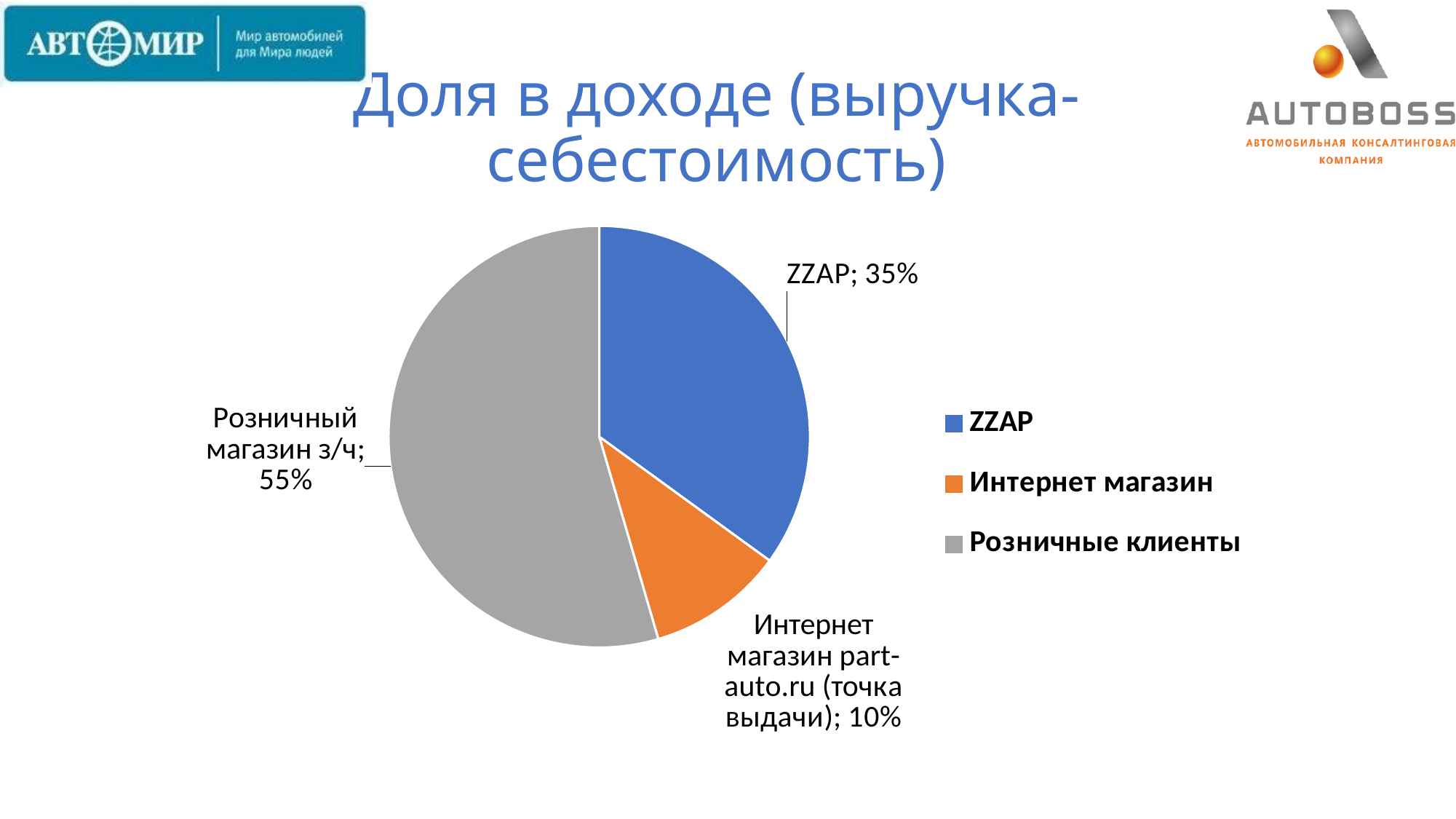
Which slice of the pie is the largest? Розничный магазин з/ч How many entries does the legend list? 3 What is the difference in percentage points between the Розничный магазин з/ч slice and the ZZAP slice? 20 How many slices does the pie chart have? 3 Which slice of the pie is the smallest? Интернет магазин part-auto.ru (точка выдачи) What share of the pie does Интернет магазин part-auto.ru (точка выдачи) have? 10% What share of the pie does ZZAP have? 35% What colour is the ZZAP slice in the pie chart? Blue What kind of chart is shown on the slide? Pie chart What is the title of the slide's chart? Доля в доходе (выручка-себестоимость) Which is larger, the ZZAP slice or the Интернет магазин part-auto.ru slice? ZZAP What share of the pie does Розничный магазин з/ч have? 55%